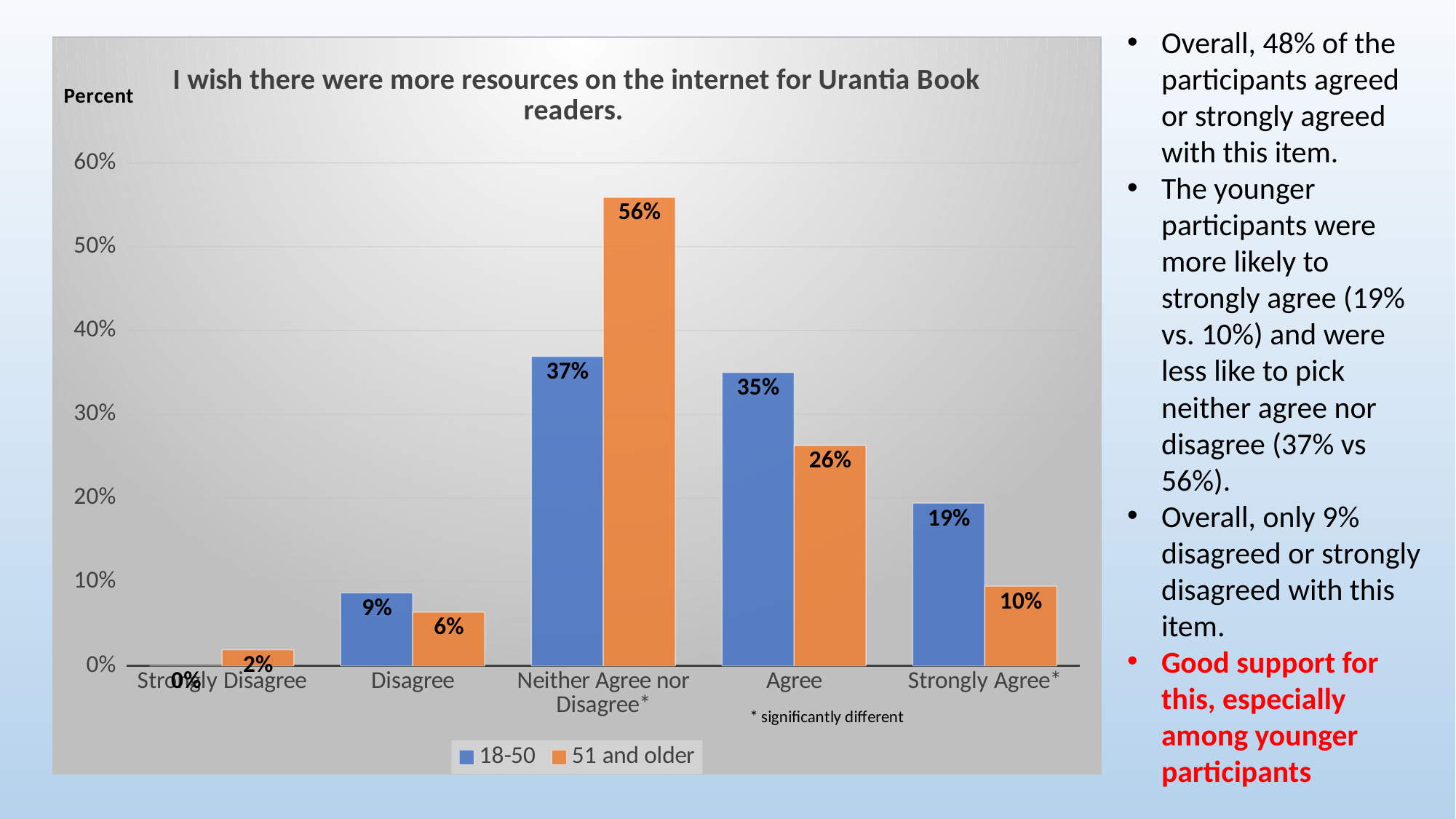
Which response category has the lowest value for the 18-50 group? Strongly Disagree What percentage of the 51 and older group chose Disagree? 6% What kind of chart is shown on the slide? Bar chart Which group has the larger value for Agree, 18-50 or 51 and older? 18-50 How many series does the legend list? 2 What percentage of the 51 and older group chose Strongly Agree? 10% How many response categories are shown on the x axis? 5 Which colour represents the 51 and older group? Orange Which response category has the highest value for the 51 and older group? Neither Agree nor Disagree Is the value for the 51 and older group at Agree greater or less than 30%? less What percentage of the 18-50 group chose Neither Agree nor Disagree? 37% What is the difference between the 51 and older and 18-50 values for Neither Agree nor Disagree? 19%